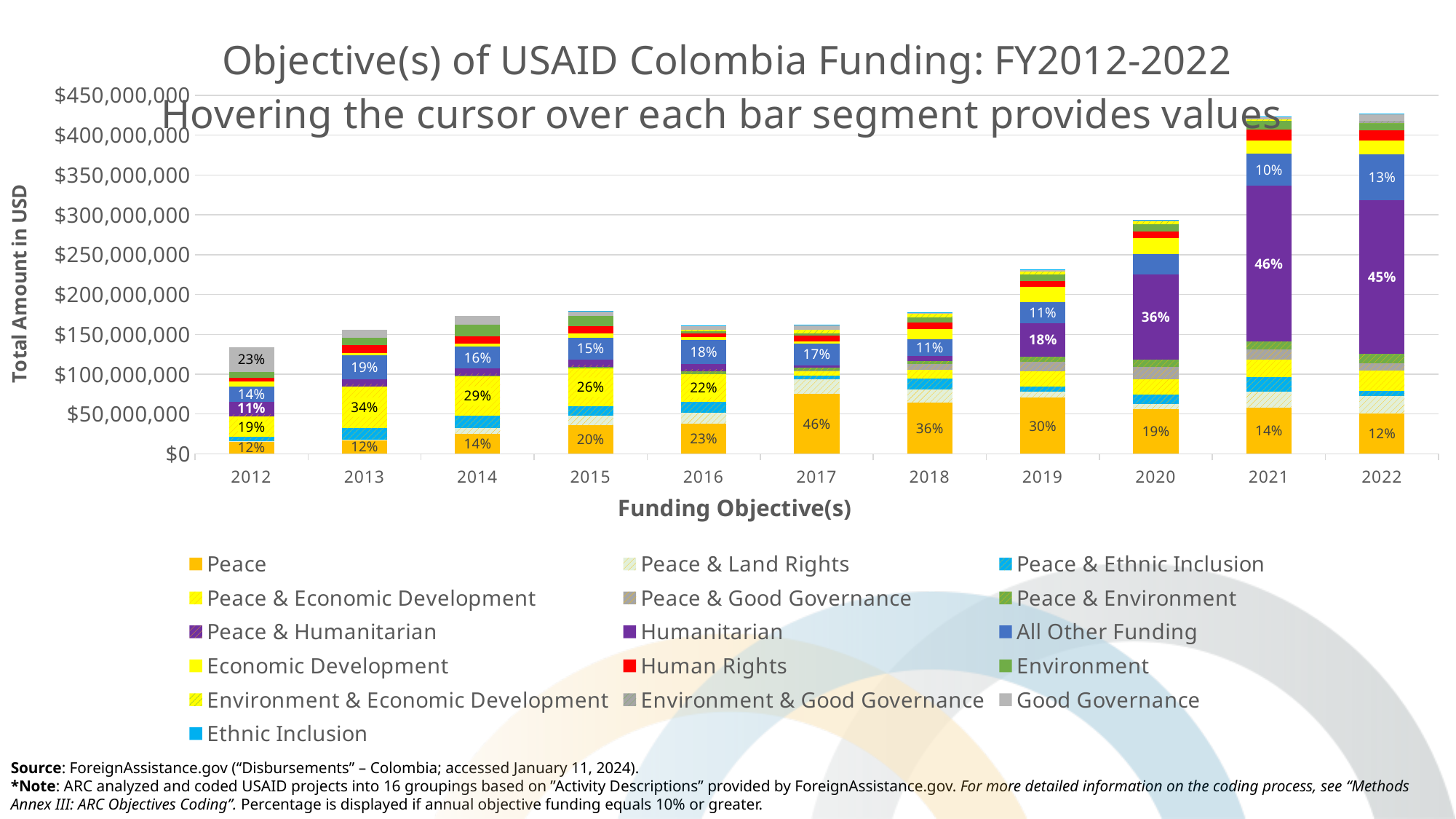
By how many percentage points did the Peace share fall from 2017 to 2022? 34 percentage points What percentage of funding went to All Other Funding in 2013? 19% What percentage of funding went to Peace in 2017? 46% What type of chart is shown on the slide? Stacked bar chart How many years (bars) are shown on the x axis? 11 Is the total funding for 2021 greater or less than $400,000,000? greater Does the Humanitarian share rise or fall from 2019 to 2021? Rise What percentage of funding went to Humanitarian in 2021? 46% Which year has the lowest total funding amount? 2012 What percentage of funding went to Good Governance in 2012? 23% Which year has the highest total funding amount? 2022 How many funding objective series does the legend list? 16